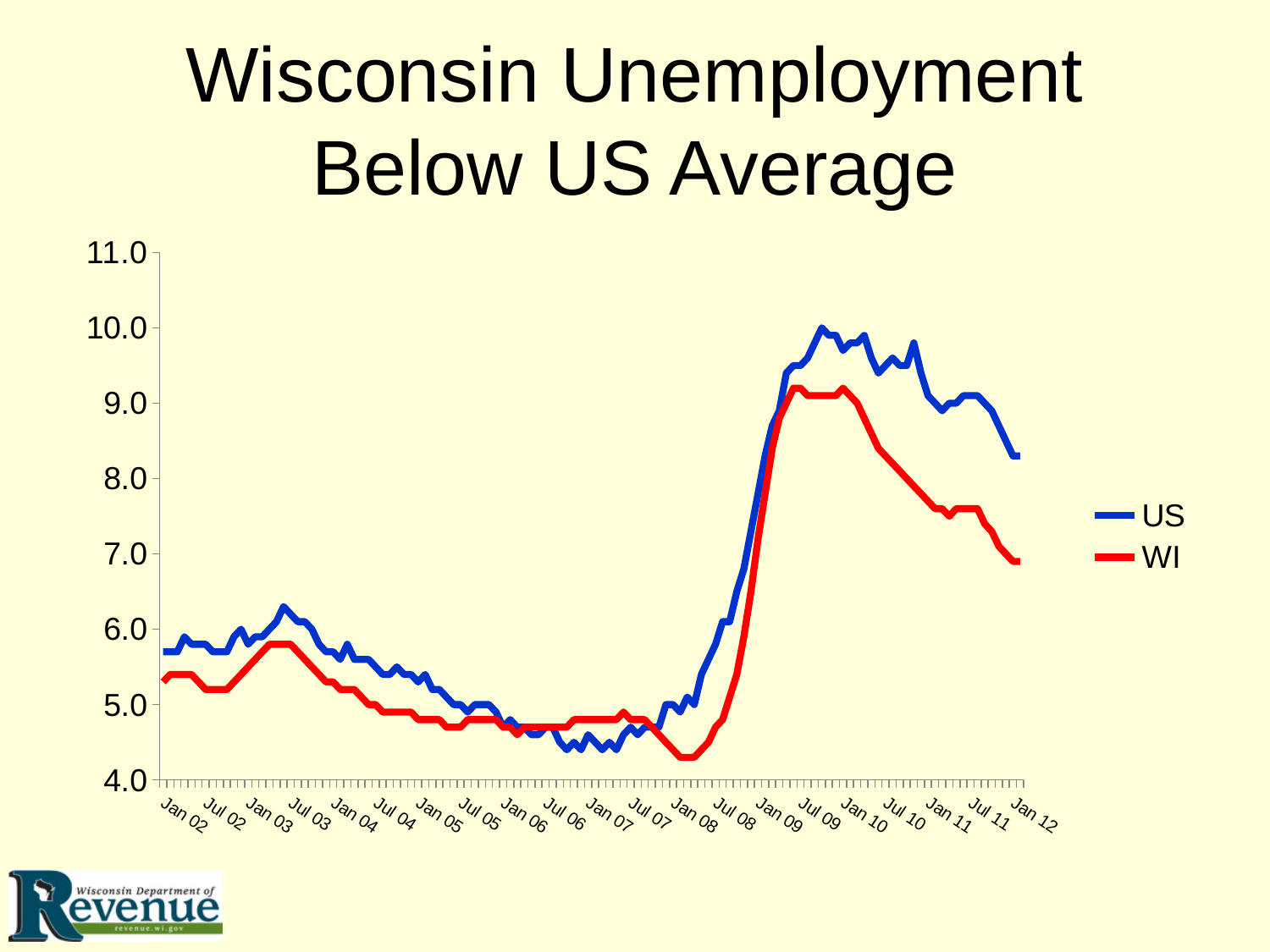
Is the value for WI at Jan 08 greater or less than 5.0? less Does the US line rise or fall between Jan 08 and Jul 09? rise What is the title of the slide? Wisconsin Unemployment Below US Average Which series reaches the higher peak value, US or WI? US At Jan 12, which series has the higher value, US or WI? US Is the value for US at Jan 10 greater or less than 9.0? greater What are the two series named in the legend? US and WI Is the value for US at Jan 12 greater or less than 8.0? greater How many series does the legend list? 2 What kind of chart is shown on the slide? line chart Does the WI line rise or fall between Jan 10 and Jan 12? fall